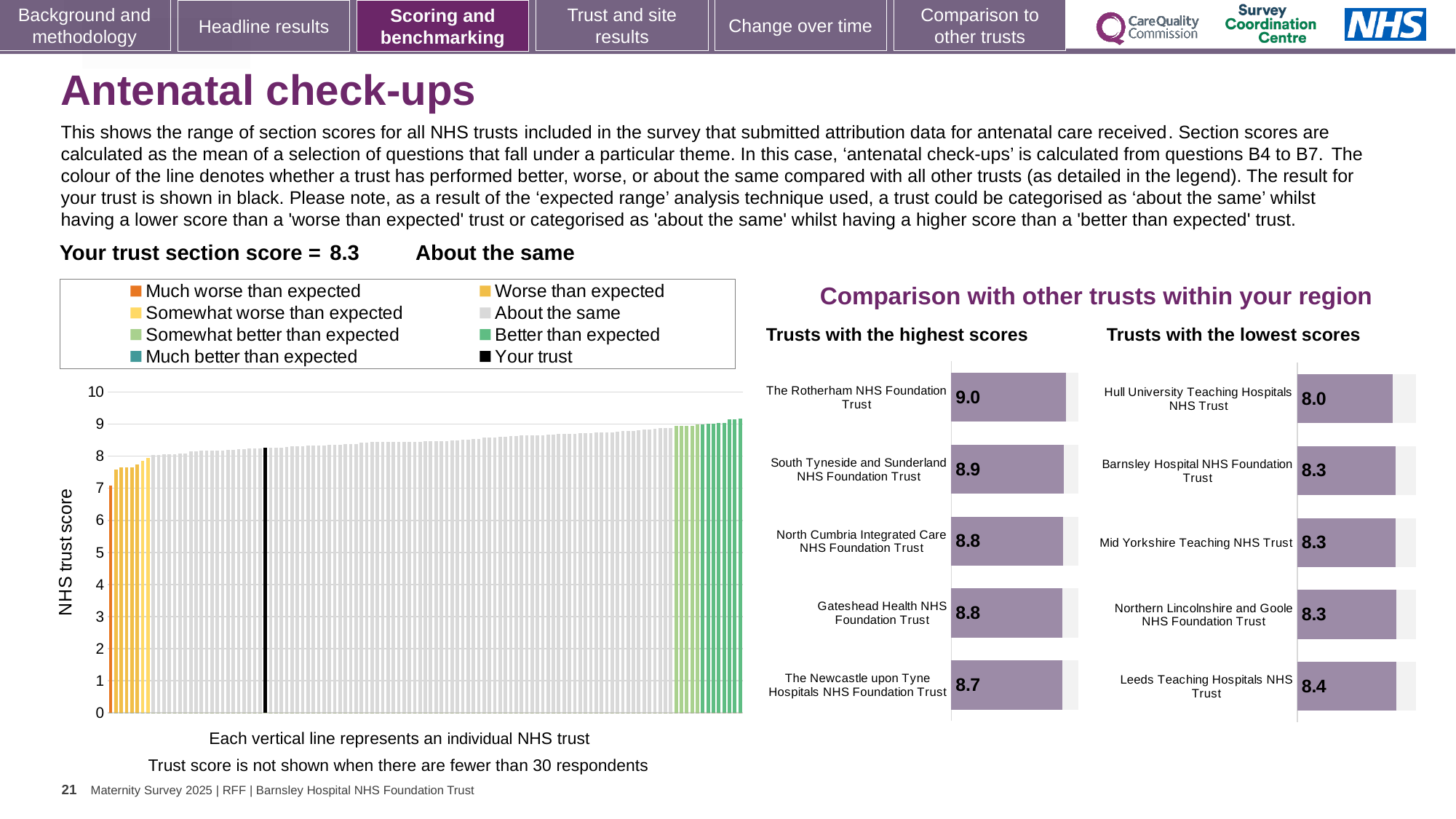
What kind of chart is the large 'NHS trust score' chart on the left? Bar chart In the 'Trusts with the lowest scores' chart, which trust has the lowest score? Hull University Teaching Hospitals NHS Trust In the large 'NHS trust score' chart on the left, do the values rise or fall from left to right? Rise In the large 'NHS trust score' chart on the left, is the value of the leftmost (orange) bar greater or less than 8? less How many entries does the legend above the large 'NHS trust score' chart list? 8 How many trusts are shown in the 'Trusts with the highest scores' chart? 5 In the 'Trusts with the lowest scores' chart, what is the score for Hull University Teaching Hospitals NHS Trust? 8.0 In the 'Trusts with the highest scores' chart, what is the score for The Rotherham NHS Foundation Trust? 9.0 In the 'Trusts with the lowest scores' chart, which has the larger score: Leeds Teaching Hospitals NHS Trust or Hull University Teaching Hospitals NHS Trust? Leeds Teaching Hospitals NHS Trust In the 'Trusts with the lowest scores' chart, what is the score for Leeds Teaching Hospitals NHS Trust? 8.4 In the 'Trusts with the highest scores' chart, which trust has the highest score? The Rotherham NHS Foundation Trust In the 'Trusts with the highest scores' chart, what is the difference between the scores of The Rotherham NHS Foundation Trust and The Newcastle upon Tyne Hospitals NHS Foundation Trust? 0.3